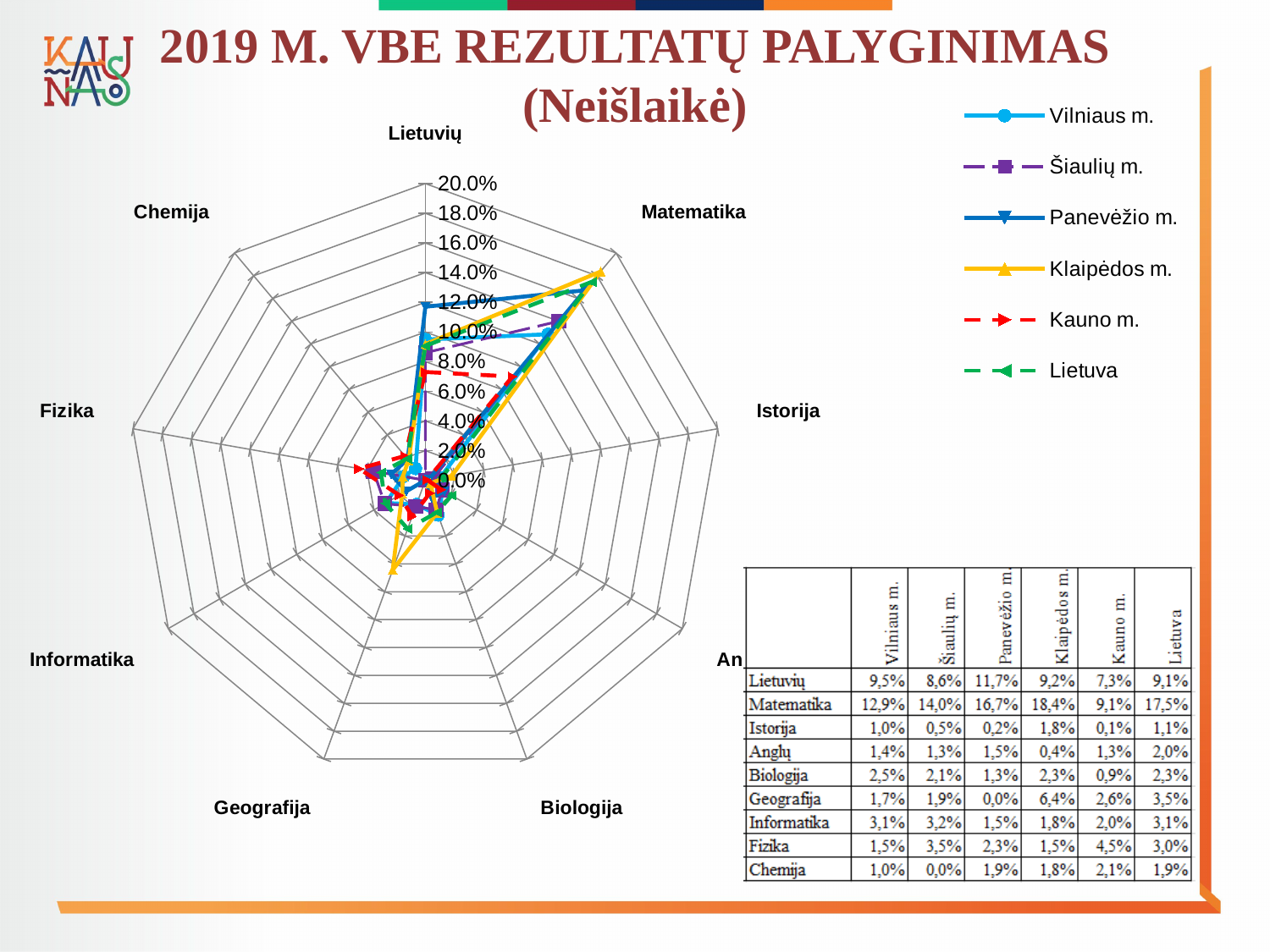
How many series does the chart legend list? 6 Which series has the lowest value in Geografija? Panevėžio m. What is the value for Kauno m. in Istorija? 0,1% What is the value for Klaipėdos m. in Matematika? 18,4% Which subject has the highest value for Klaipėdos m.? Matematika What kind of chart is shown on the slide? Radar chart What is the value for Panevėžio m. in Lietuvių? 11,7% Which is larger in Fizika: Kauno m. or Šiaulių m.? Kauno m. Which series has the highest value in Lietuvių? Panevėžio m. Is the value for Panevėžio m. in Matematika greater or less than 16.0%? greater What is the difference between the Matematika values for Klaipėdos m. and Vilniaus m.? 5,5% How many subject categories are plotted on the radar chart? 9